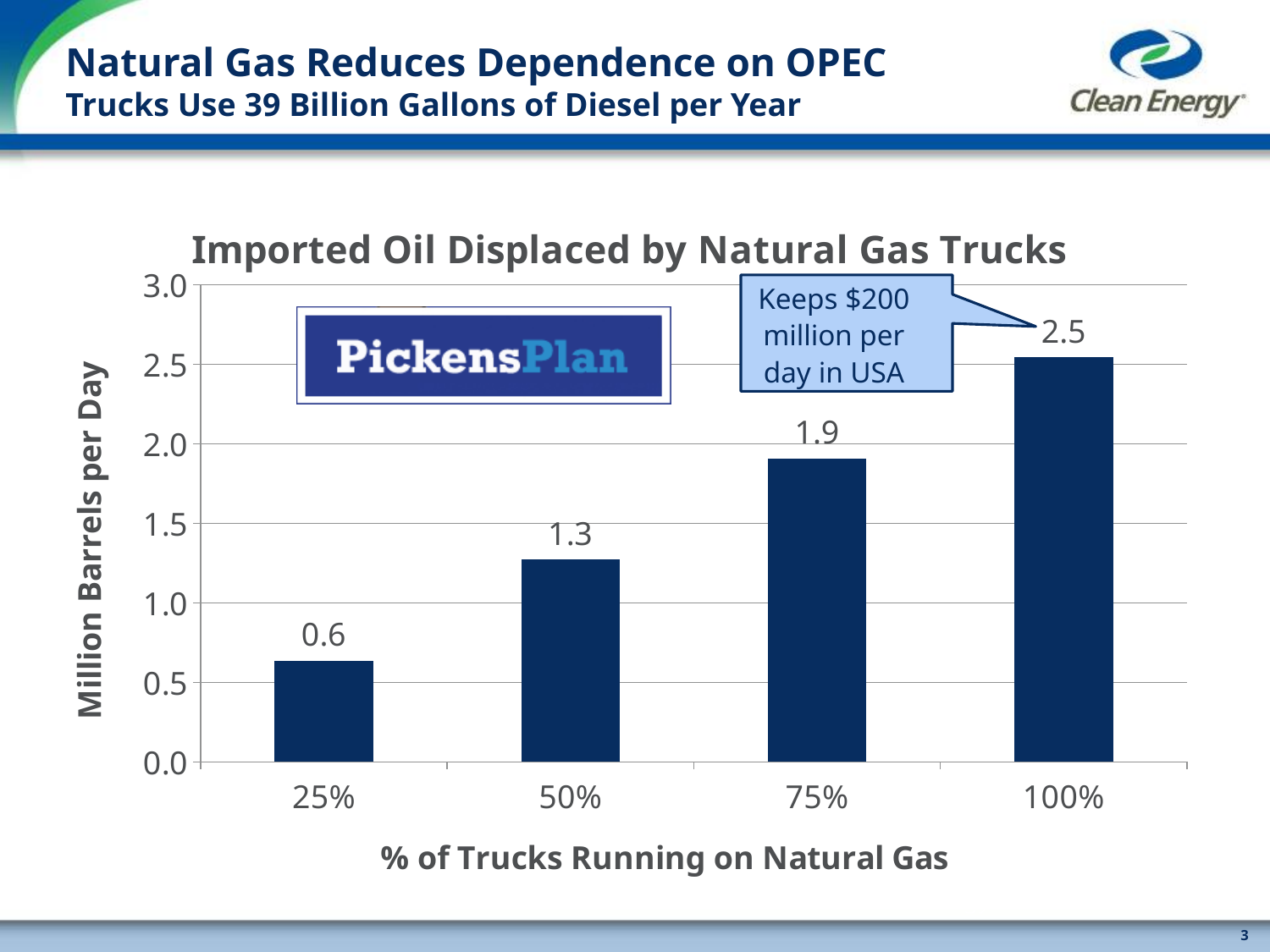
What is the value for 50% of trucks running on natural gas? 1.3 What is the value for 100% of trucks running on natural gas? 2.5 What kind of chart is this? Bar chart Do the values rise or fall as the percentage of trucks running on natural gas increases? Rise How many categories are shown on the x axis? 4 Which category has the lowest value? 25% What is the value for 75% of trucks running on natural gas? 1.9 What is the difference between the values for 75% and 50%? 0.6 Which category has the highest value? 100% What is the value for 25% of trucks running on natural gas? 0.6 What is the difference between the values for 100% and 25%? 1.9 Which is larger, the value for 50% or the value for 75%? 75%